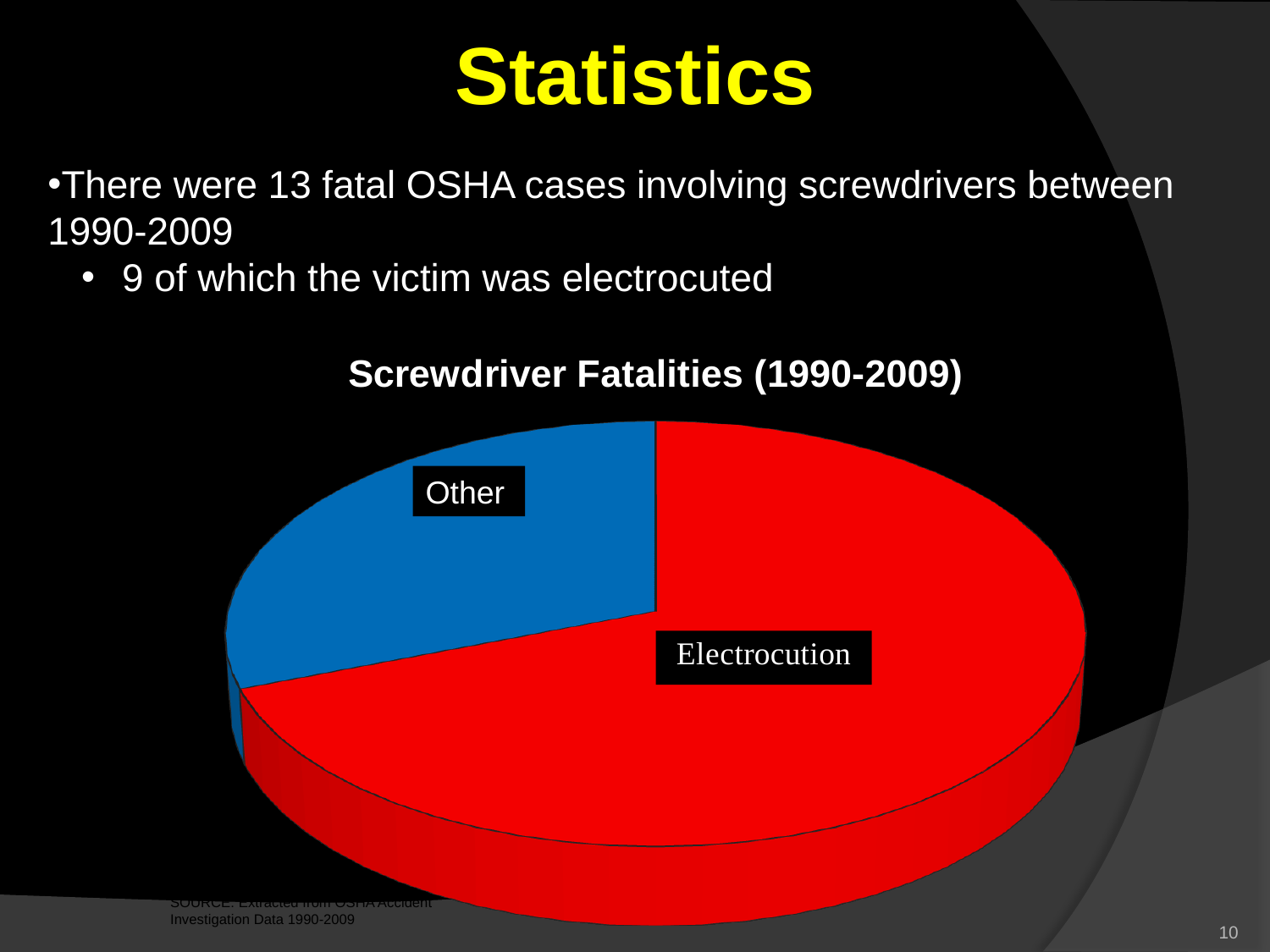
Does the Electrocution slice make up more or less than half of the pie? more What kind of chart is shown on the slide? pie chart What is the title of the chart? Screwdriver Fatalities (1990-2009) Which category has the smallest slice of the pie? Other Which slice is larger, Electrocution or Other? Electrocution How many slices does the pie chart have? 2 According to the slide, how many of the screwdriver fatalities were electrocutions? 9 What colour is the Electrocution slice? red Which category has the largest slice of the pie? Electrocution